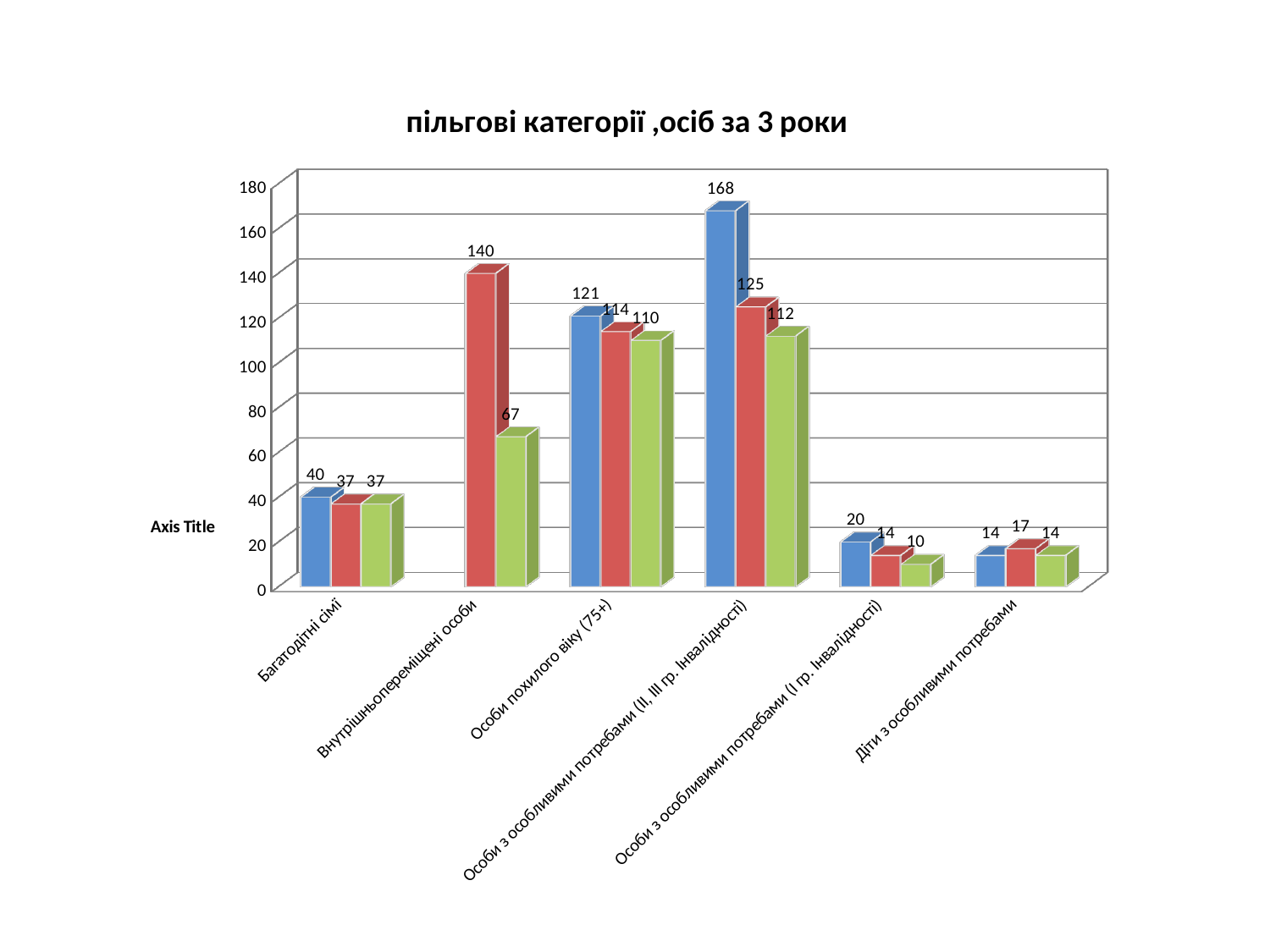
What type of chart is shown on the slide? bar chart Which category has the lowest green bar? Особи з особливими потребами (I гр. Інвалідності) What is the title of the chart? пільгові категорії ,осіб за 3 роки What is the value of the blue bar for Особи з особливими потребами (II, III гр. Інвалідності)? 168 How many categories are shown on the x axis of the chart? 6 Which is larger for Діти з особливими потребами: the red bar or the blue bar? the red bar What is the value of the green bar for Особи похилого віку (75+)? 110 What is the value of the red bar for Внутрішньопереміщені особи? 140 What is the difference between the red bar and the green bar for Внутрішньопереміщені особи? 73 What is the value of the blue bar for Багатодітні сім'ї? 40 What is the difference between the blue bar and the red bar for Особи з особливими потребами (II, III гр. Інвалідності)? 43 Which category has the highest blue bar? Особи з особливими потребами (II, III гр. Інвалідності)